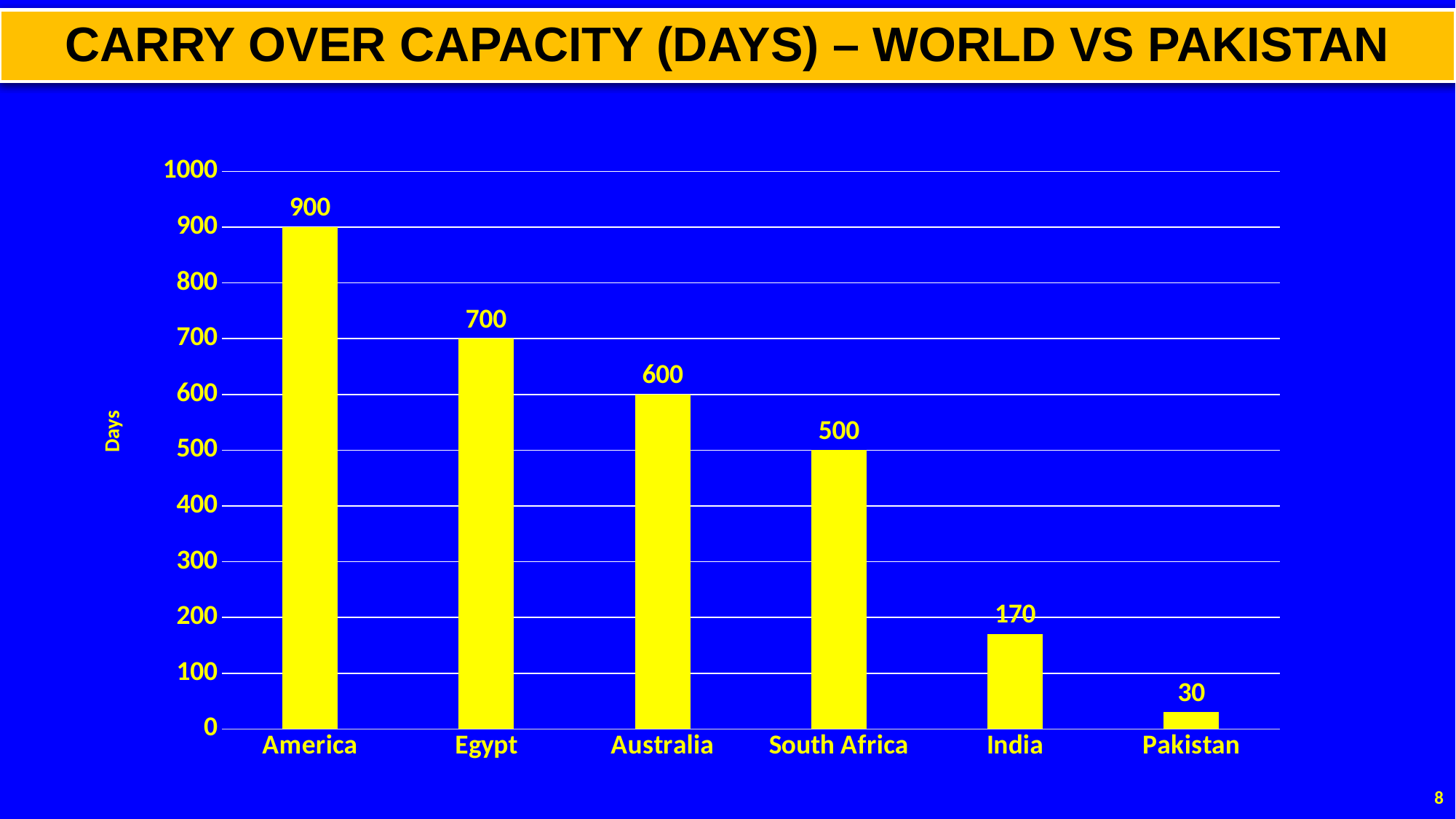
What is the difference in carry over capacity between America and Pakistan? 870 What is the difference in carry over capacity between Egypt and Australia? 100 What kind of chart is shown on the slide? Bar chart What is the carry over capacity in days for India? 170 Is the value for India greater or less than 200? less What is the carry over capacity in days for Pakistan? 30 What is the carry over capacity in days for America? 900 What is the label on the vertical axis of the chart? Days Which country has the lowest carry over capacity? Pakistan Which country has the highest carry over capacity? America Which has a larger carry over capacity, South Africa or India? South Africa How many countries are shown in the chart? 6